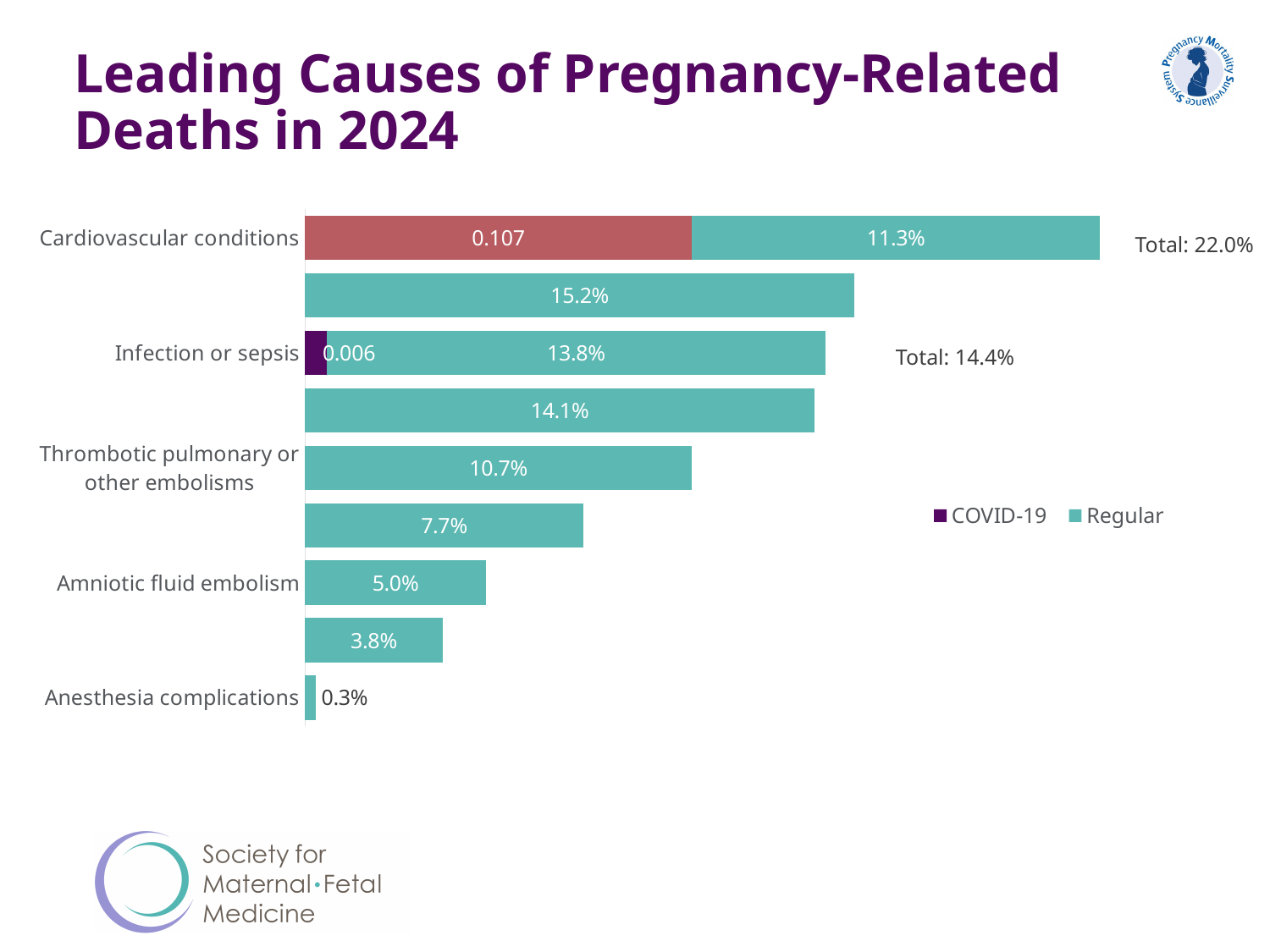
Which is larger, the value for Thrombotic pulmonary or other embolisms or the value for Amniotic fluid embolism? Thrombotic pulmonary or other embolisms What kind of chart is shown on the slide? Bar chart What is the Regular value for Cardiovascular conditions? 11.3% How many series does the legend list? 2 Which labeled cause has the lowest value? Anesthesia complications What is the value for Anesthesia complications? 0.3% What is the Regular value for Infection or sepsis? 13.8% What is the value for Thrombotic pulmonary or other embolisms? 10.7% What is the total shown for Cardiovascular conditions? 22.0% What is the total shown for Infection or sepsis? 14.4% Which labeled cause has the highest total value? Cardiovascular conditions